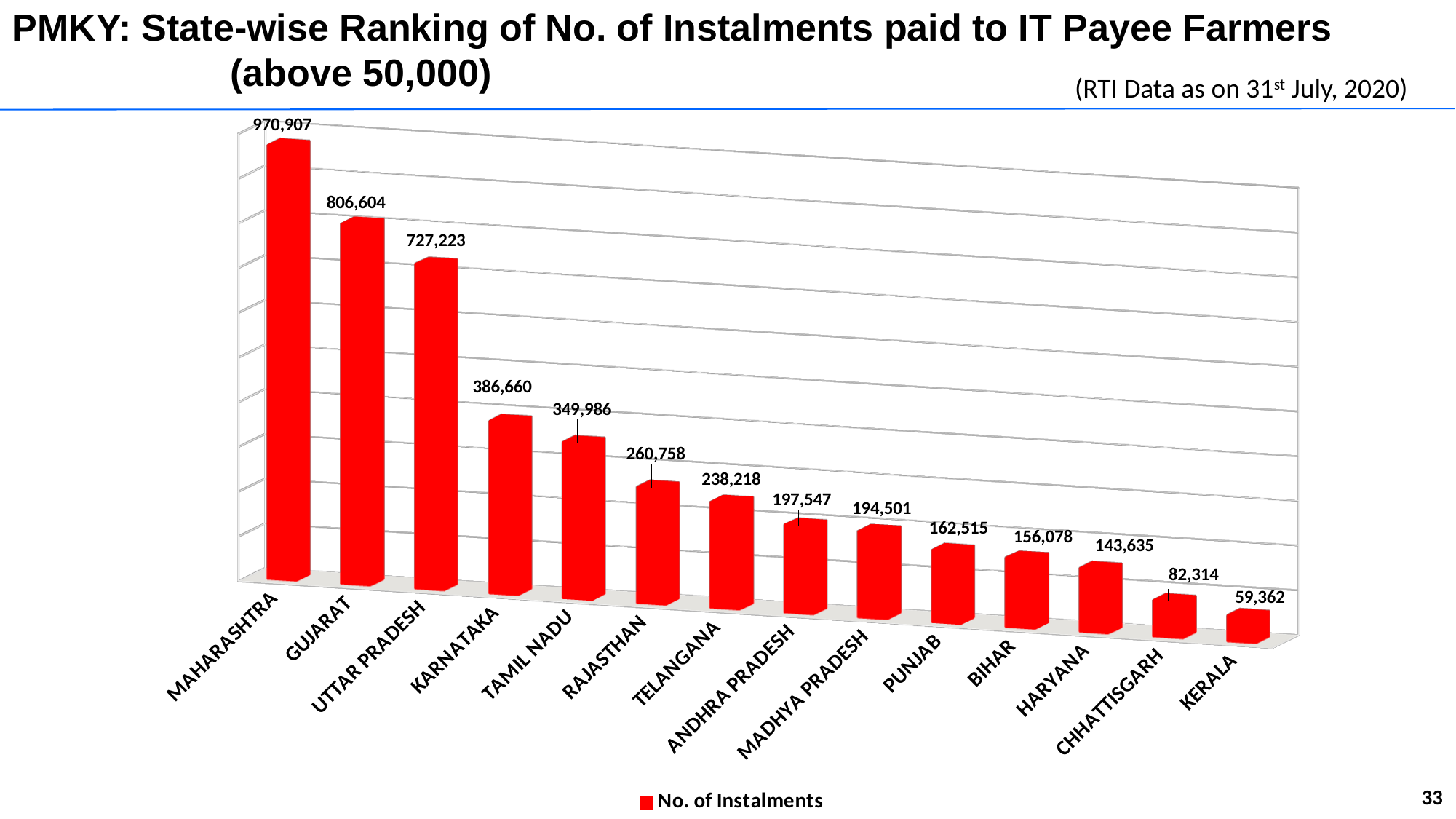
What is the number of instalments for Punjab? 162,515 How many states are shown in the chart? 14 Which has more instalments, Uttar Pradesh or Karnataka? Uttar Pradesh How many series does the legend list? 1 Which state has the highest number of instalments? Maharashtra Which state has the lowest number of instalments? Kerala What is the difference in number of instalments between Chhattisgarh and Kerala? 22,952 What kind of chart is shown on the slide? Bar chart What is the number of instalments for Maharashtra? 970,907 What is the number of instalments for Karnataka? 386,660 Do the values rise or fall from left to right across the states? Fall What is the difference in number of instalments between Maharashtra and Gujarat? 164,303